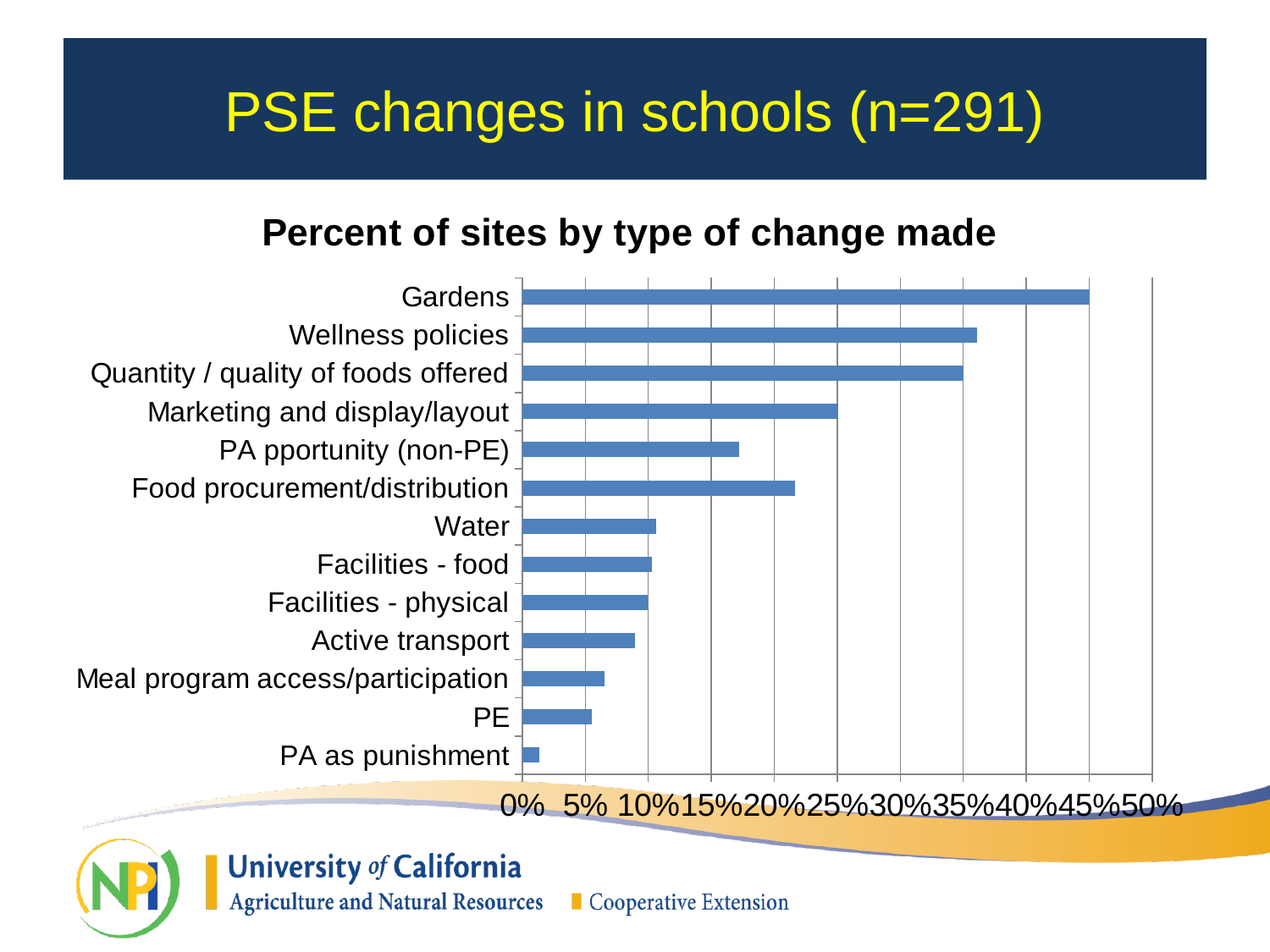
How many categories (types of change) are plotted in the chart? 13 Is the value for Gardens greater or less than 40%? greater Is the value for Active transport greater or less than 10%? less Which type of change has the highest percent of sites? Gardens Which is larger, the value for Marketing and display/layout or the value for Water? Marketing and display/layout Is the value for PA as punishment greater or less than 5%? less Which type of change has the lowest percent of sites? PA as punishment What kind of chart is shown on the slide? bar chart Which is larger, the value for Food procurement/distribution or the value for PA pportunity (non-PE)? Food procurement/distribution What is the title of the chart? Percent of sites by type of change made